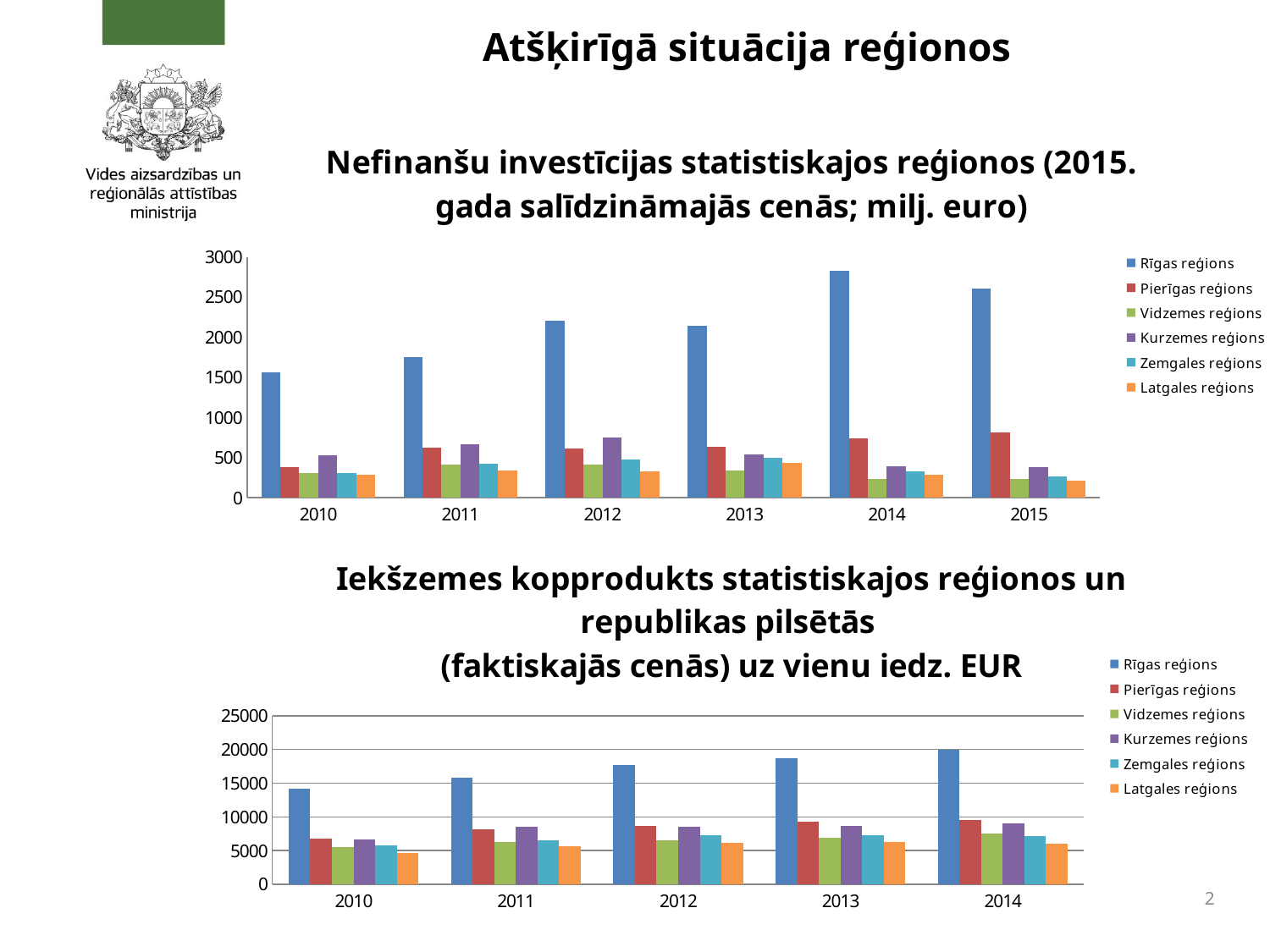
How many years are shown on the x axis of the bottom chart, 'Iekšzemes kopprodukts statistiskajos reģionos'? 5 In the bottom chart, 'Iekšzemes kopprodukts statistiskajos reģionos', which region has the lowest value in 2010? Latgales reģions In the bottom chart, 'Iekšzemes kopprodukts statistiskajos reģionos', is the value for Rīgas reģions in 2013 greater or less than 15000? greater In the top chart, 'Nefinanšu investīcijas statistiskajos reģionos', is the value for Latgales reģions in 2015 greater or less than 500? less In the top chart, 'Nefinanšu investīcijas statistiskajos reģionos', which region has the highest value in 2014? Rīgas reģions In the top chart, 'Nefinanšu investīcijas statistiskajos reģionos', which is larger in 2012: Kurzemes reģions or Pierīgas reģions? Kurzemes reģions In the top chart, 'Nefinanšu investīcijas statistiskajos reģionos', in which year is the value for Rīgas reģions highest? 2014 How many years are shown on the x axis of the top chart, 'Nefinanšu investīcijas statistiskajos reģionos'? 6 How many series does the legend of the bottom chart, 'Iekšzemes kopprodukts statistiskajos reģionos', list? 6 In the top chart, 'Nefinanšu investīcijas statistiskajos reģionos', is the value for Rīgas reģions in 2014 greater or less than 2500? greater What kind of chart is the top chart, 'Nefinanšu investīcijas statistiskajos reģionos'? bar chart In the bottom chart, 'Iekšzemes kopprodukts statistiskajos reģionos', does the value for Rīgas reģions rise or fall from 2010 to 2014? rise